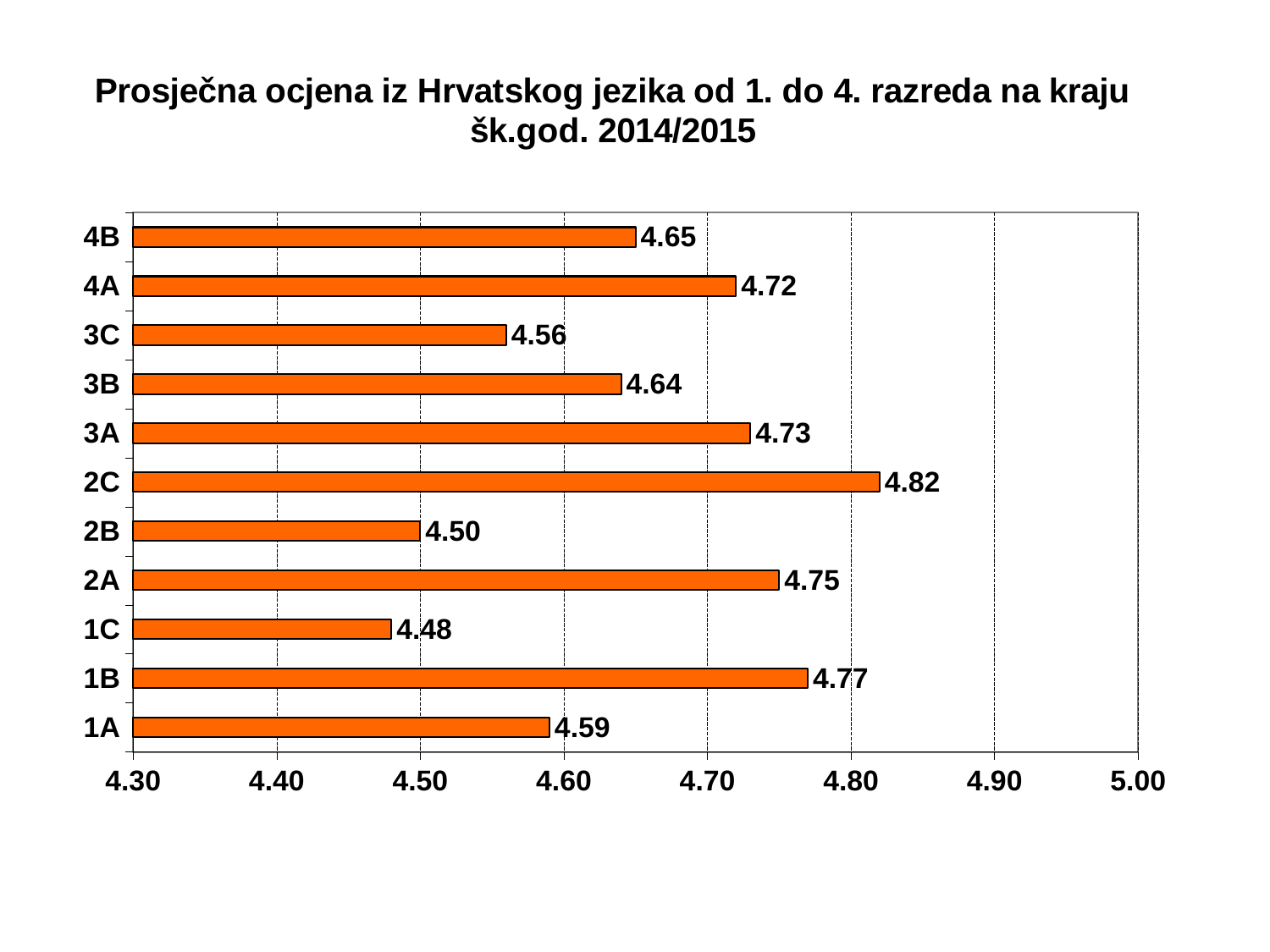
What kind of chart is shown on the slide? Bar chart What is the average grade for class 2C? 4.82 Is the value for 2B greater or less than 4.60? less What is the difference between the average grades of 1B and 1A? 0.18 Which class has a higher average grade, 3A or 3C? 3A What is the average grade for class 3B? 4.64 Which class has the lowest average grade? 1C What is the average grade for class 1C? 4.48 What is the difference between the average grades of 2C and 2B? 0.32 How many classes are shown in the chart? 11 What is the maximum value shown on the horizontal axis? 5.00 Which class has the highest average grade? 2C